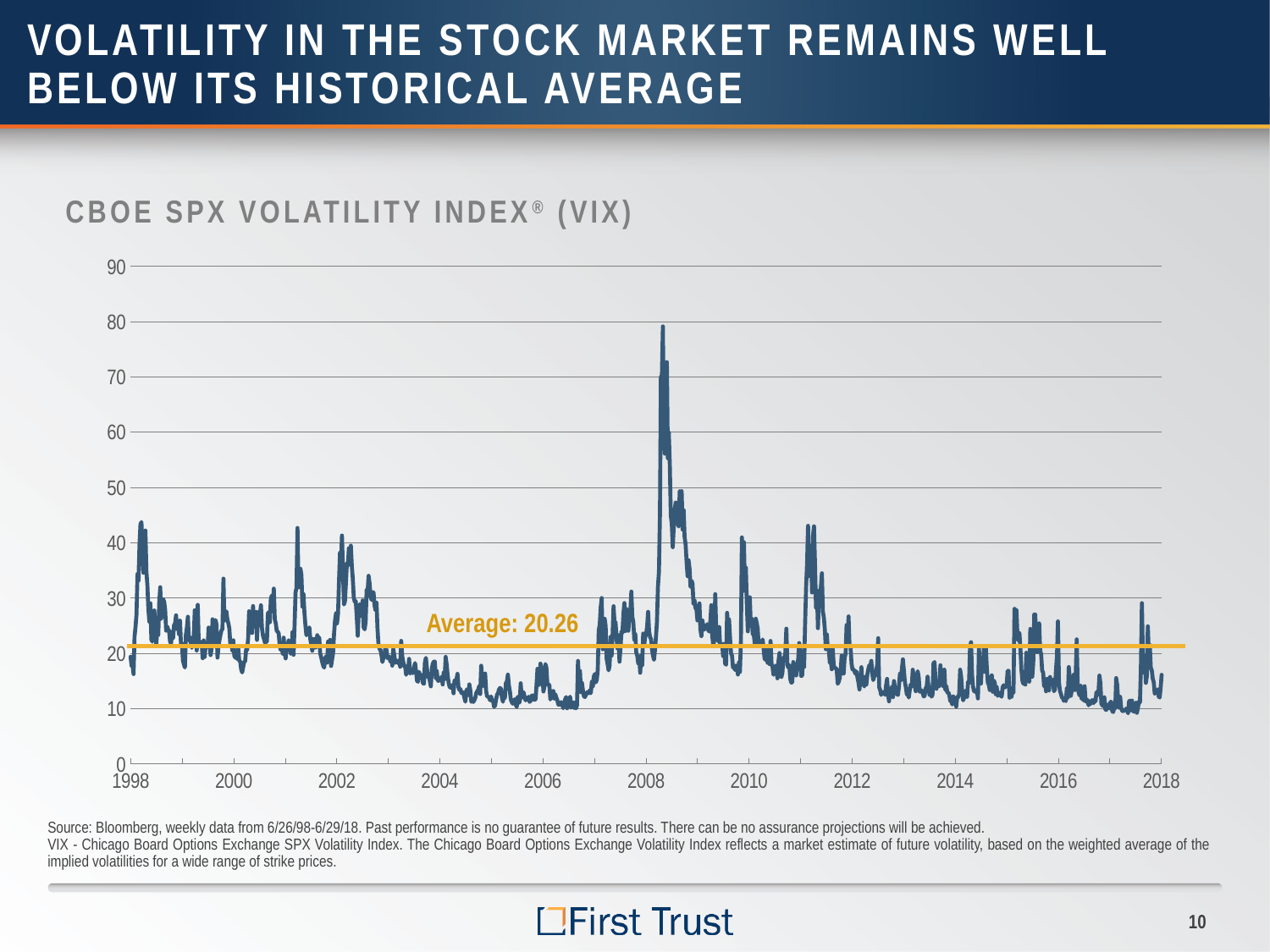
In which year does the VIX reach its highest peak on the chart? 2008 Is the VIX value in mid-2006 greater or less than 20? less What is the highest value shown on the vertical axis? 90 Is the peak value of the VIX in 2008 greater or less than 70? greater Does the VIX rise or fall from its 2008 peak to 2018? fall Is the VIX value at the end of the chart in 2018 greater or less than 20? less What average value is printed on the chart's horizontal reference line? 20.26 What kind of chart is shown on the slide? line chart What is the first year labeled on the horizontal axis? 1998 What is the title of the chart? CBOE SPX Volatility Index (VIX) Which is higher, the VIX peak in 2008 or the VIX peak in 2011? 2008